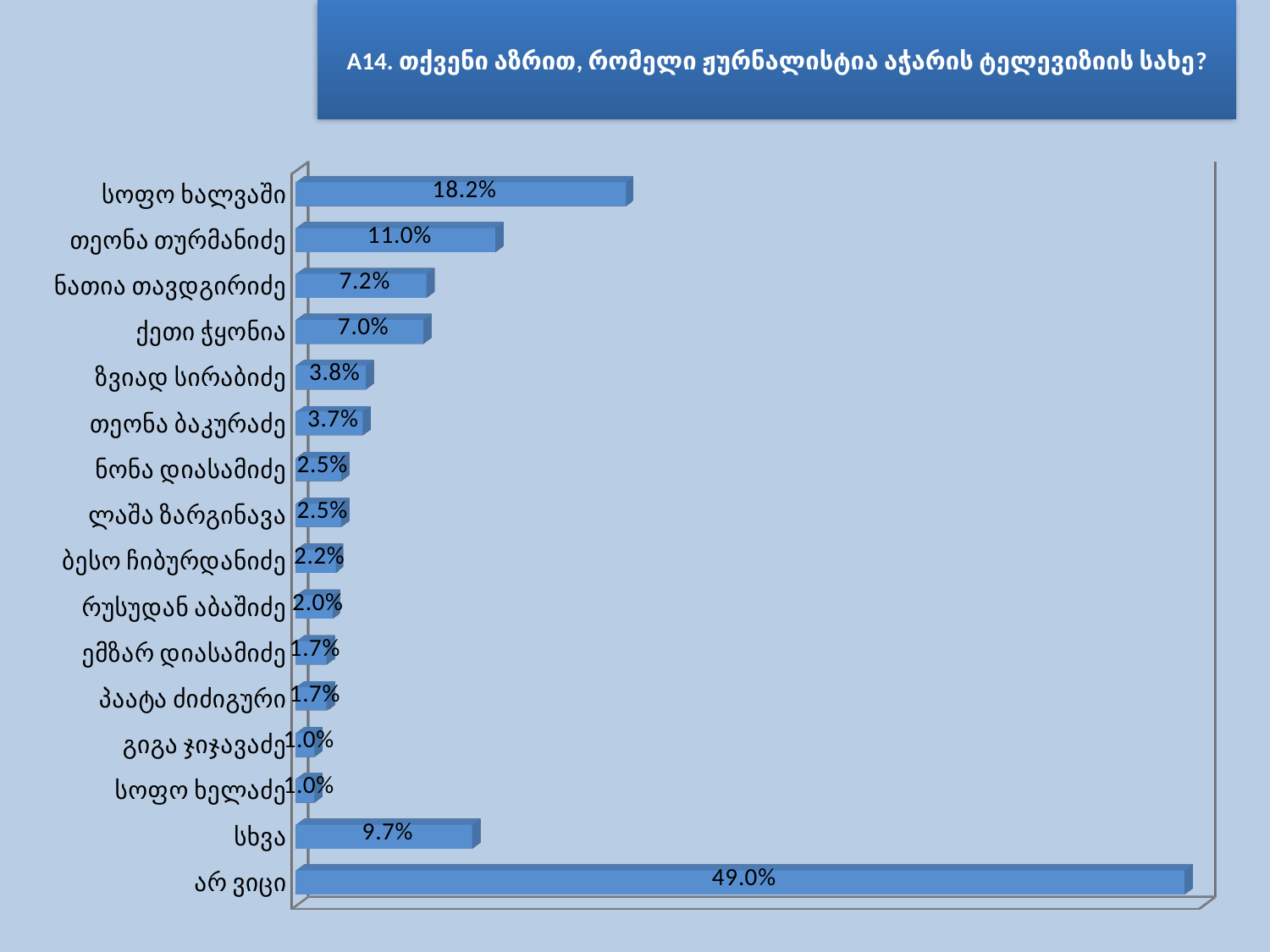
What is the value for ზვიად სირაბიძე? 3.8% Which named journalist has the highest value? სოფო ხალვაში What is the value for თეონა თურმანიძე? 11.0% Which category has the highest value? არ ვიცი What is the difference between the values for არ ვიცი and სხვა? 39.3% What kind of chart is shown on the slide? Bar chart What is the difference between the values for სოფო ხალვაში and თეონა თურმანიძე? 7.2% How many categories are shown in the chart? 16 What is the title of the chart? A14. თქვენი აზრით, რომელი ჟურნალისტია აჭარის ტელევიზიის სახე? Which is larger, the value for ნათია თავდგირიძე or the value for თეონა ბაკურაძე? ნათია თავდგირიძე What is the value for სოფო ხალვაში? 18.2% What is the value for სხვა? 9.7%